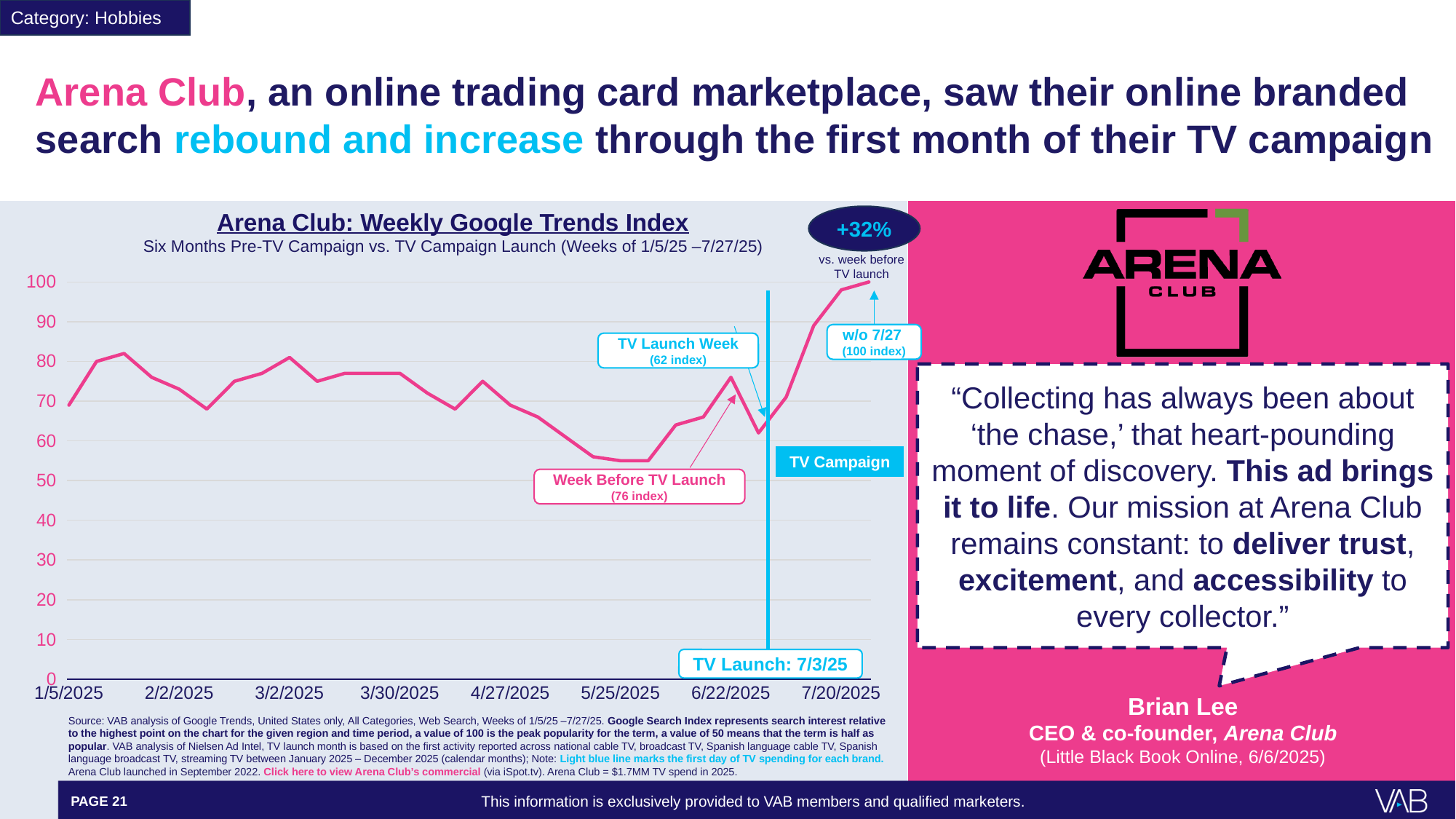
What is the index value for the week of 7/27? 100 Is the index value at 5/25/2025 greater or less than 60? less What is the difference between the index for the Week Before TV Launch and the TV Launch Week? 14 What is the Google Trends index value for the TV Launch Week? 62 Is the index value at 1/5/2025 greater or less than 80? less What is the index value for the Week Before TV Launch? 76 Which is larger, the index for the Week Before TV Launch or the TV Launch Week? Week Before TV Launch What kind of chart is shown on the slide? line chart What is the difference between the index for the week of 7/27 and the TV Launch Week? 38 What TV launch date is marked on the chart? 7/3/25 Does the index rise or fall from the TV Launch Week to the week of 7/27? rise Which labeled week has the highest index value on the chart? w/o 7/27